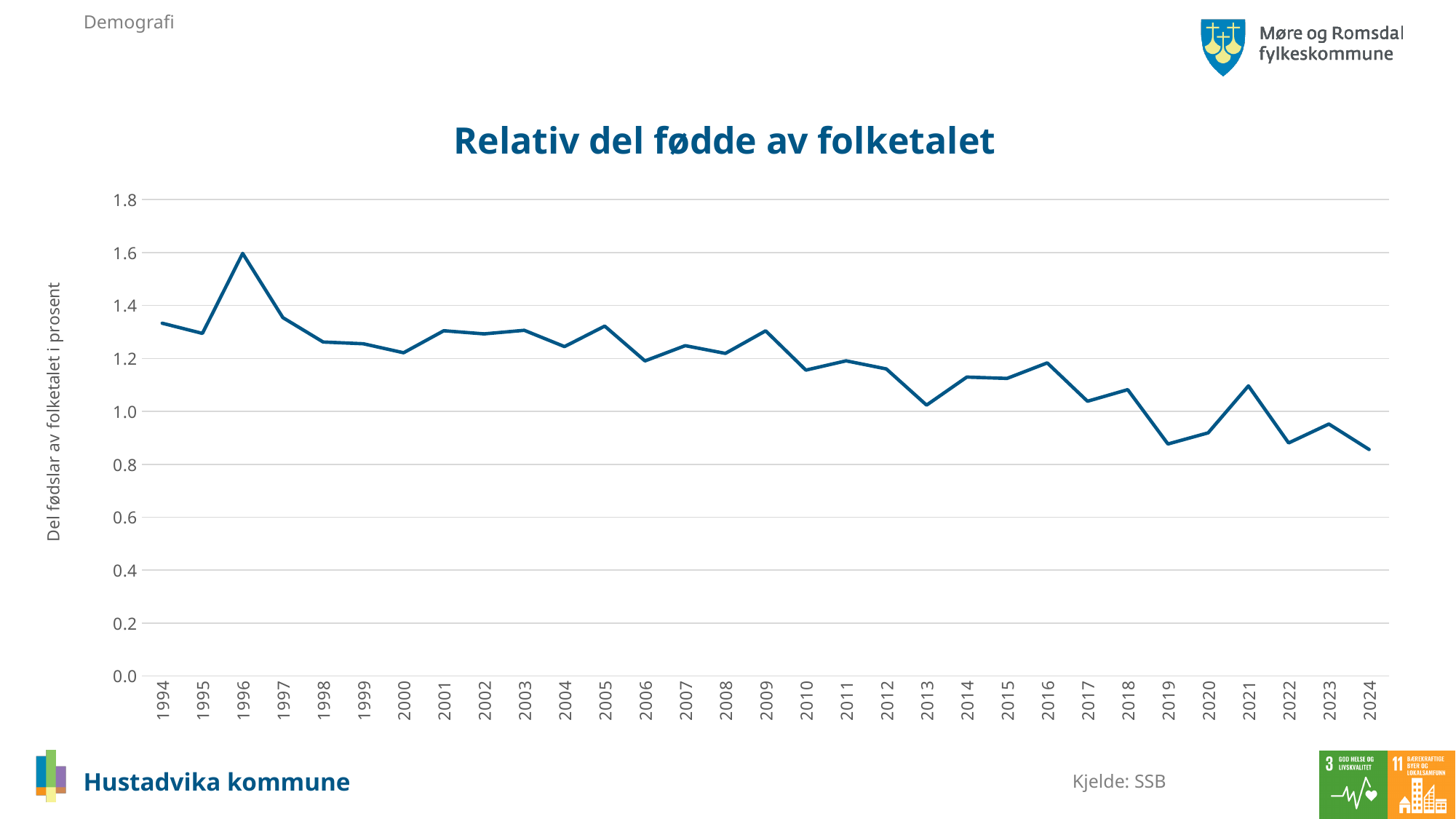
Which year has the larger value, 2009 or 2010? 2009 Do the values generally rise or fall from 1994 to 2024? fall Is the value for 1996 greater or less than 1.4? greater Is the value for 2019 greater or less than 1.0? less What kind of chart is shown on the slide? line chart What is the title of the chart? Relativ del fødde av folketalet Is the value for 2010 greater or less than 1.2? less Which year has the highest value in the chart? 1996 Which year has the larger value, 2021 or 2022? 2021 What is the label on the vertical axis of the chart? Del fødslar av folketalet i prosent How many years are plotted along the x axis? 31